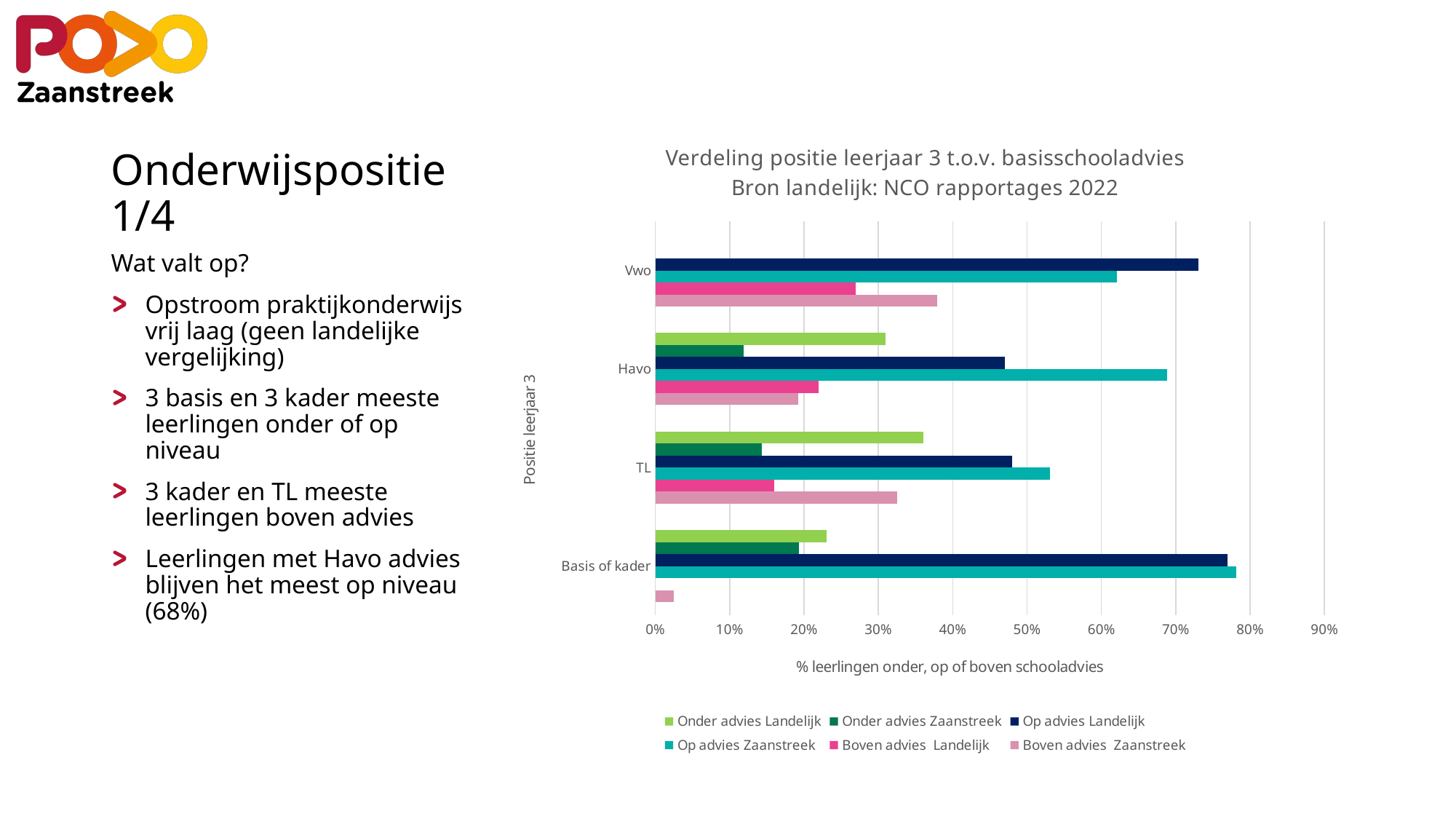
Is the value of 'Op advies Landelijk' for Vwo greater or less than 70%? greater For Havo, which is larger: 'Op advies Zaanstreek' or 'Op advies Landelijk'? Op advies Zaanstreek For Vwo, which is larger: 'Op advies Landelijk' or 'Op advies Zaanstreek'? Op advies Landelijk Is the value of 'Op advies Landelijk' for TL greater or less than 50%? less Is the value of 'Onder advies Landelijk' for TL greater or less than 30%? greater What kind of chart is shown on the slide? bar chart Which category has the highest value for 'Op advies Zaanstreek'? Basis of kader How many categories are shown on the vertical axis of the chart? 4 How many series does the chart legend list? 6 What is the label of the horizontal axis of the chart? % leerlingen onder, op of boven schooladvies